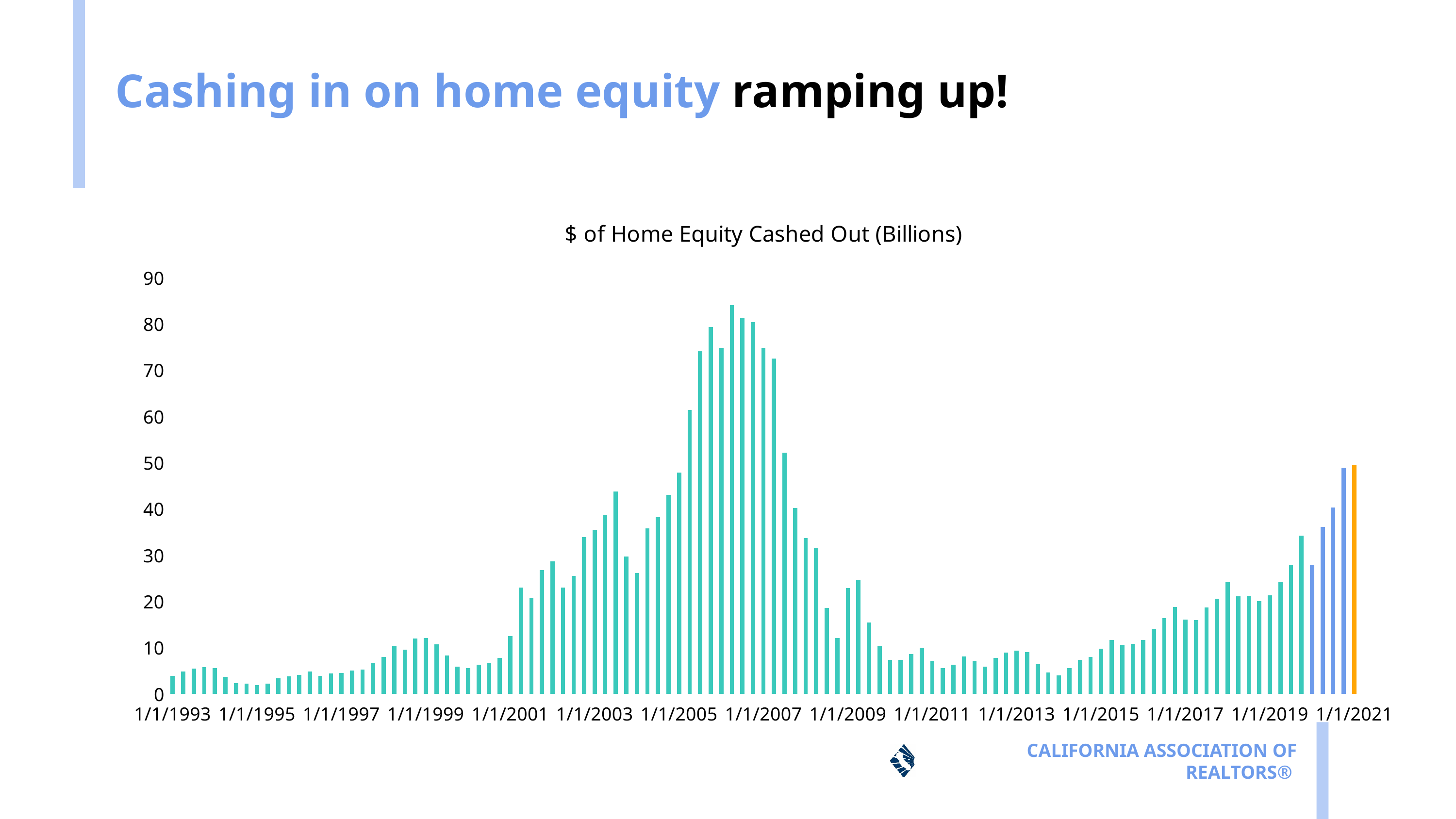
Is the value for 1/1/2011 greater or less than 10? less Is the value for 1/1/2021 greater or less than 40? greater Is the value for 1/1/2007 greater or less than 70? greater What is the title of the chart? $ of Home Equity Cashed Out (Billions) Which is larger, the value for 1/1/2007 or the value for 1/1/2021? 1/1/2007 How many date labels are shown on the x axis? 15 What kind of chart is shown on the slide? bar chart What colour is the last bar on the right of the chart (1/1/2021)? orange Do the values generally rise or fall from 1/1/2017 to 1/1/2021? rise Which is larger, the value for 1/1/1993 or the value for 1/1/2021? 1/1/2021